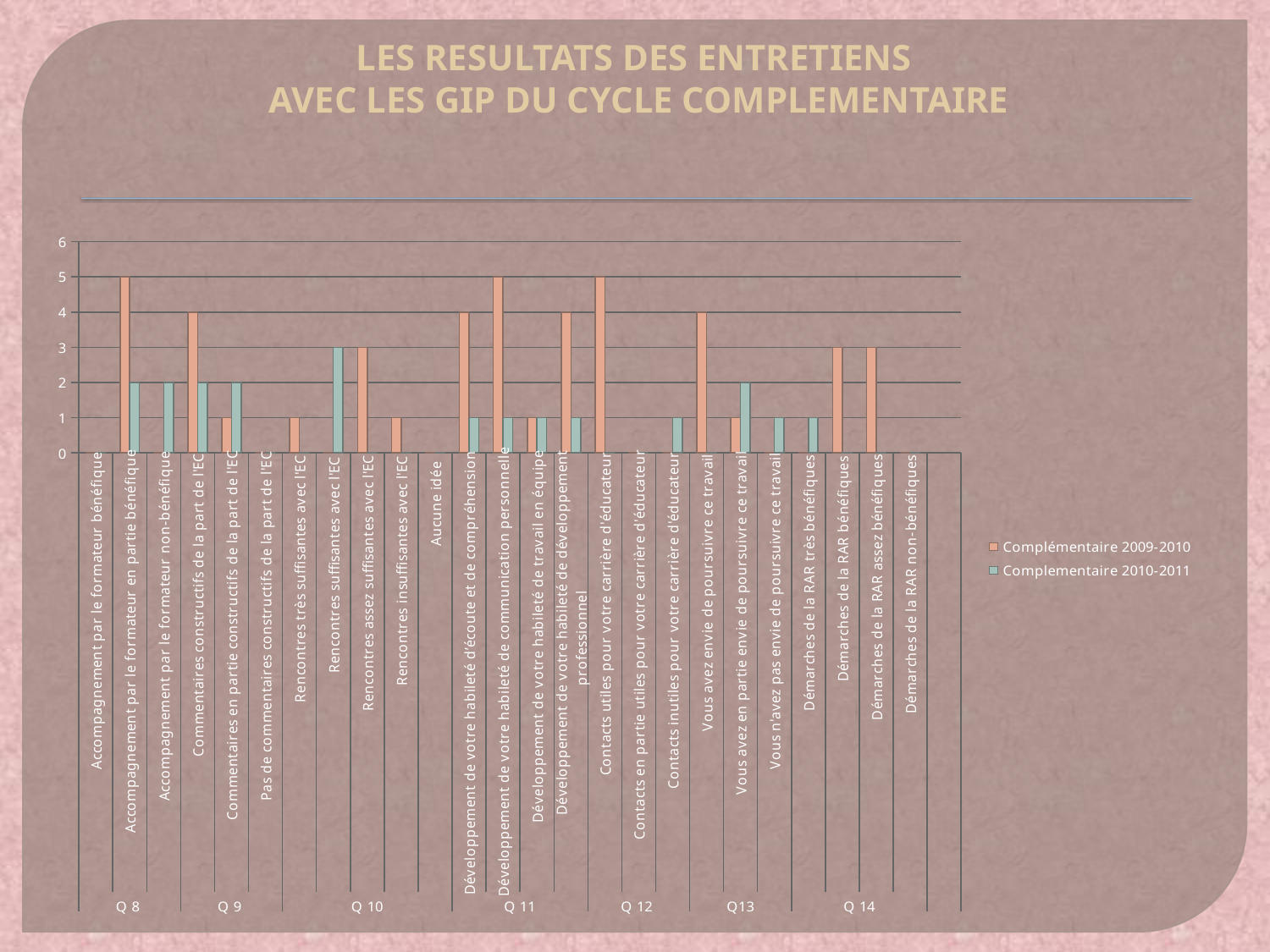
What type of chart is shown on the slide? bar chart What is the value for 'Contacts utiles pour votre carrière d'éducateur' in the Complémentaire 2009-2010 series? 5 What is the value for 'Vous avez en partie envie de poursuivre ce travail' in the Complementaire 2010-2011 series? 2 What is the value for 'Démarches de la RAR bénéfiques' in the Complémentaire 2009-2010 series? 3 Is the Complémentaire 2009-2010 value for 'Vous avez envie de poursuivre ce travail' greater or less than 2? greater What is the highest value shown on the vertical axis? 6 Which question groups are labelled along the bottom of the chart? Q 8, Q 9, Q 10, Q 11, Q 12, Q13, Q 14 What is the value for 'Développement de votre habileté de communication personnelle' in the Complémentaire 2009-2010 series? 5 What is the value for 'Rencontres suffisantes avec l'EC' in the Complementaire 2010-2011 series? 3 For 'Commentaires constructifs de la part de l'EC', which series has the larger value: Complémentaire 2009-2010 or Complementaire 2010-2011? Complémentaire 2009-2010 What is the difference between the Complémentaire 2009-2010 and Complementaire 2010-2011 values for 'Développement de votre habileté d'écoute et de compréhension'? 3 How many series does the legend list? 2